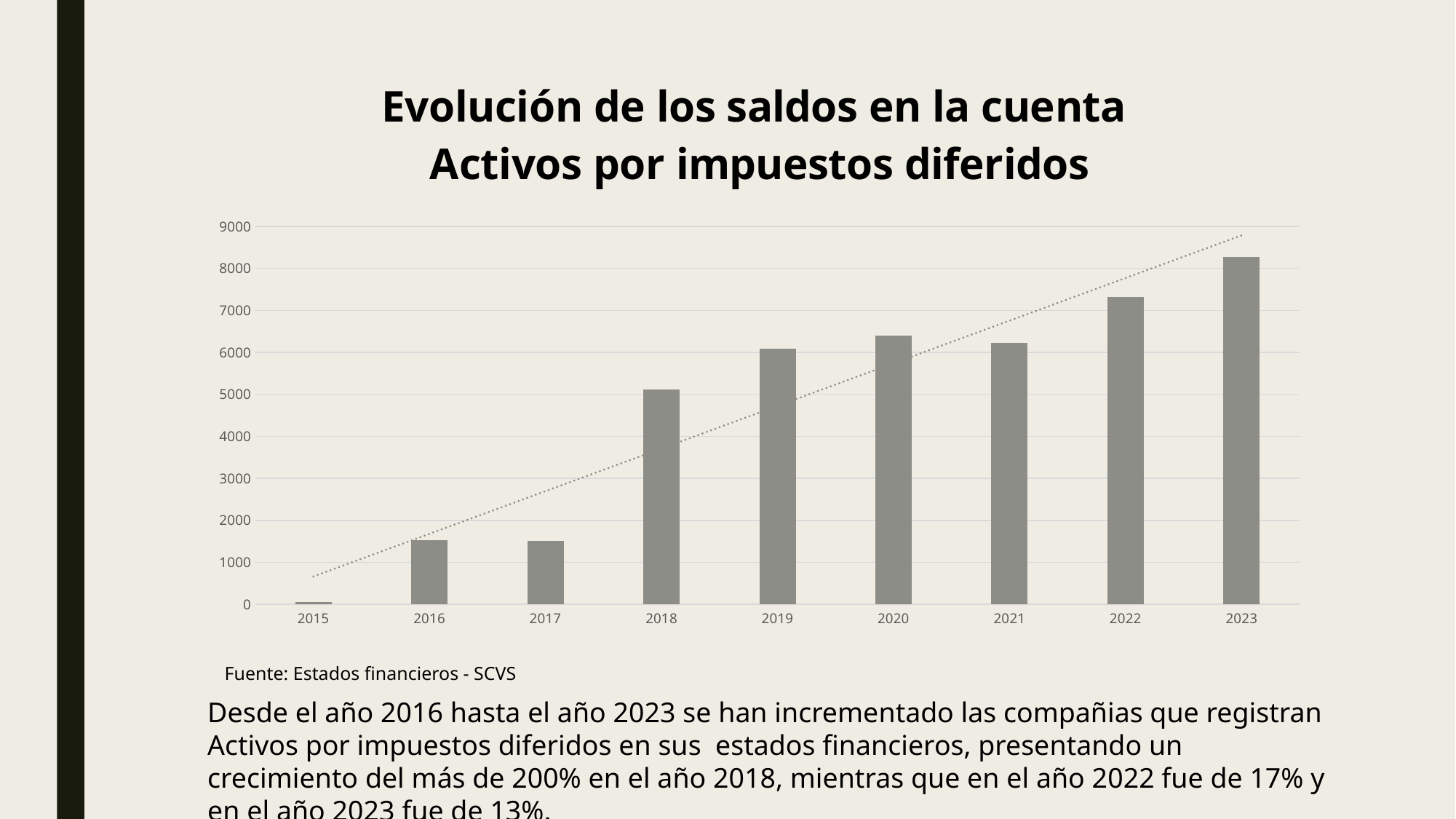
Is the value for 2022 greater or less than 7000? greater Which year has the lowest value in the chart? 2015 Is the value for 2018 greater or less than 4000? greater Which is larger, the value for 2018 or the value for 2017? 2018 Is the value for 2021 greater or less than 7000? less Do the values generally rise or fall from 2015 to 2023? Rise What is the title of the chart? Evolución de los saldos en la cuenta Activos por impuestos diferidos Which year has the highest value in the chart? 2023 How many years are shown on the x axis of the chart? 9 What kind of chart is shown on the slide? Bar chart